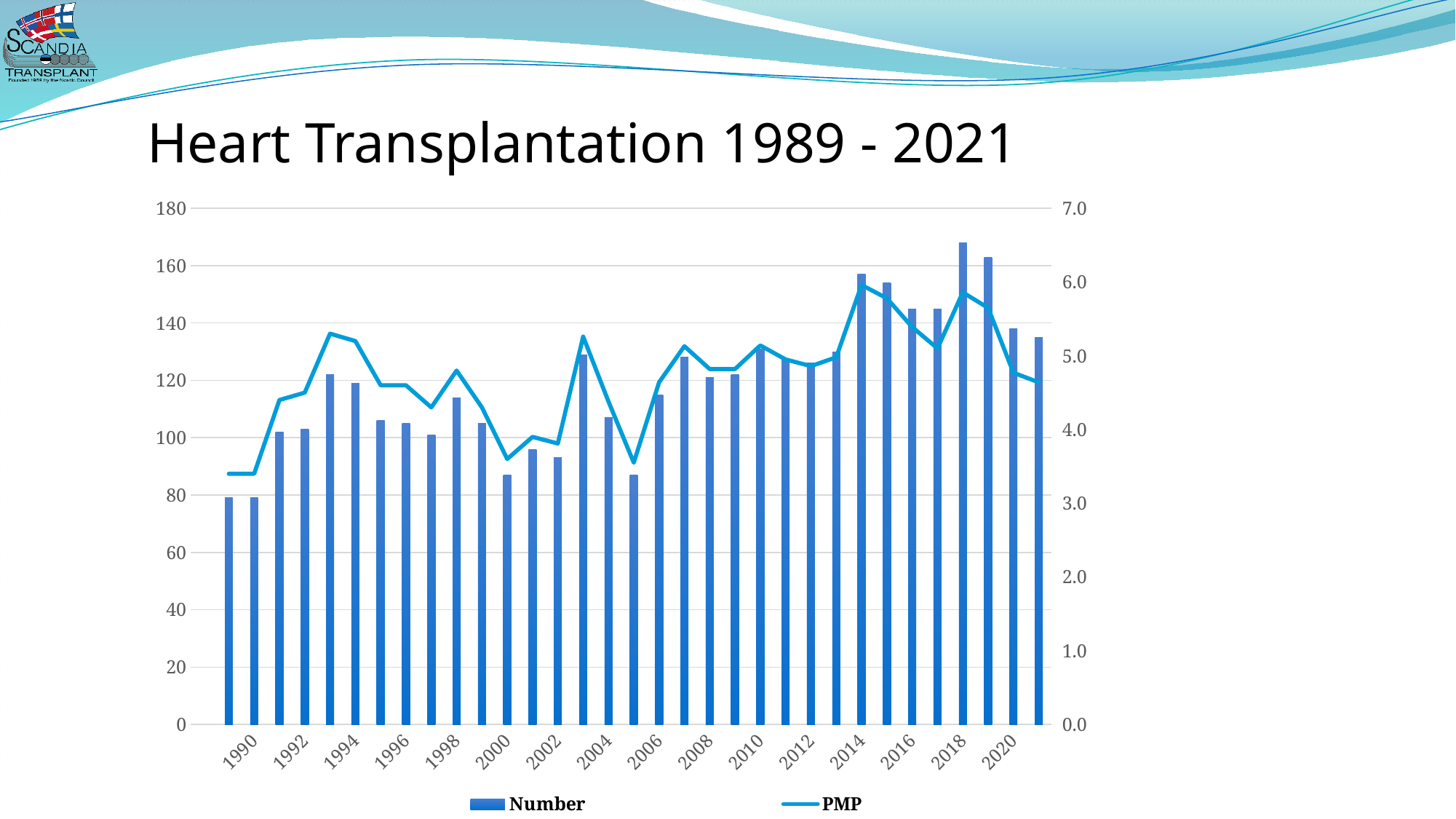
Is the Number value for 2018 greater or less than 160? greater Which year has the highest Number bar? 2018 What is the title of the chart? Heart Transplantation 1989 - 2021 What are the two series named in the legend? Number and PMP How many bars (years) are plotted in the chart? 33 Which year has the larger Number bar, 2000 or 2004? 2004 Is the Number value for 2014 greater or less than 140? greater Is the PMP value for 1990 greater or less than 4.0? less What kind of chart is shown on the slide? A combined bar and line chart How many series does the legend list? 2 Does the PMP line rise or fall from 2018 to 2021? fall